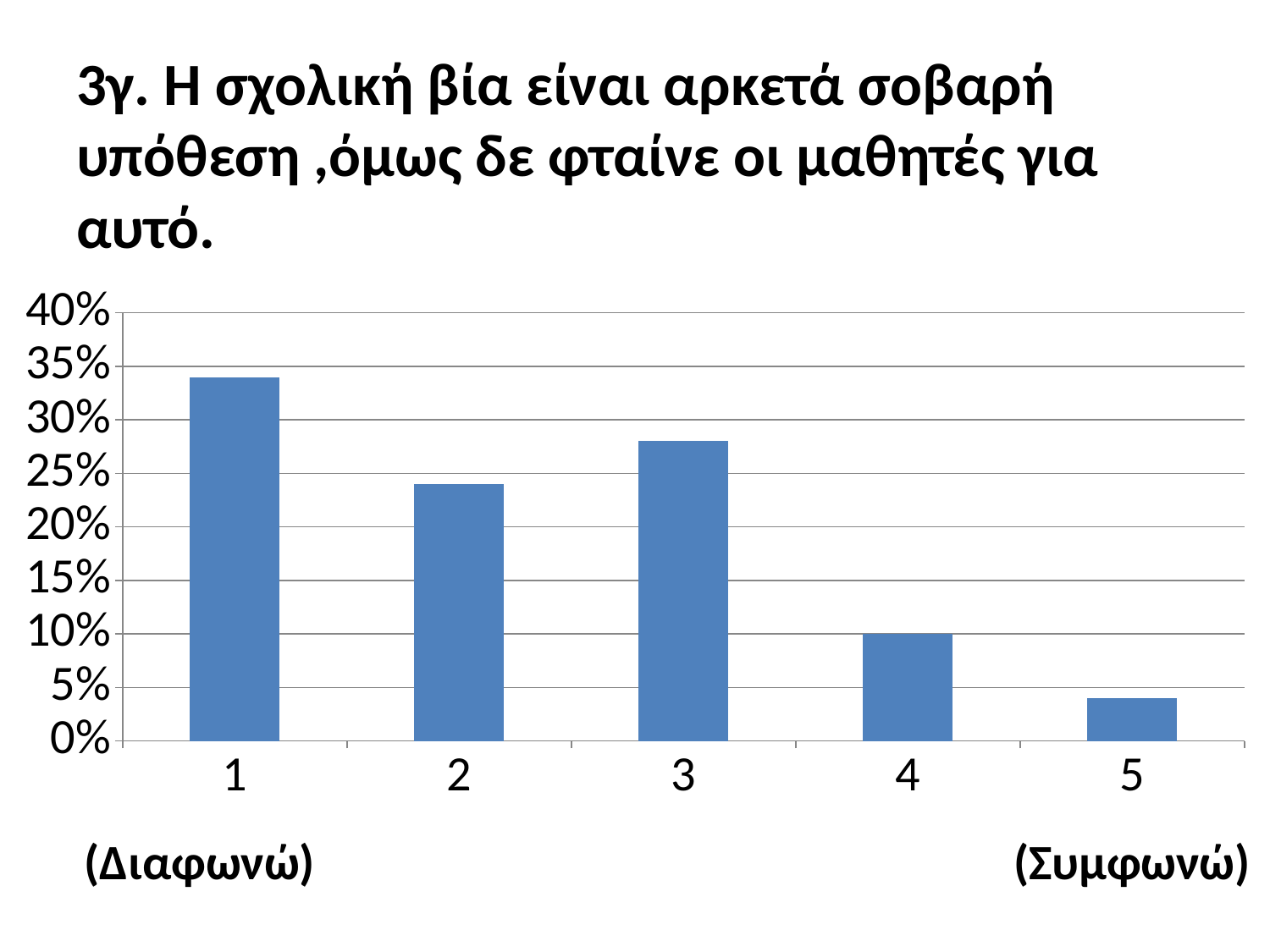
Which is larger, the value for category 2 or the value for category 3? 3 Is the value for category 1 greater or less than 30%? greater Is the value for category 3 greater or less than 25%? greater What label appears under the right end of the x axis, beneath category 5? (Συμφωνώ) How many categories are plotted on the x axis? 5 Which category has the highest bar? 1 What label appears under the left end of the x axis, beneath category 1? (Διαφωνώ) What kind of chart is shown on the slide? bar chart Which category has the lowest bar? 5 Which is larger, the value for category 1 or the value for category 3? 1